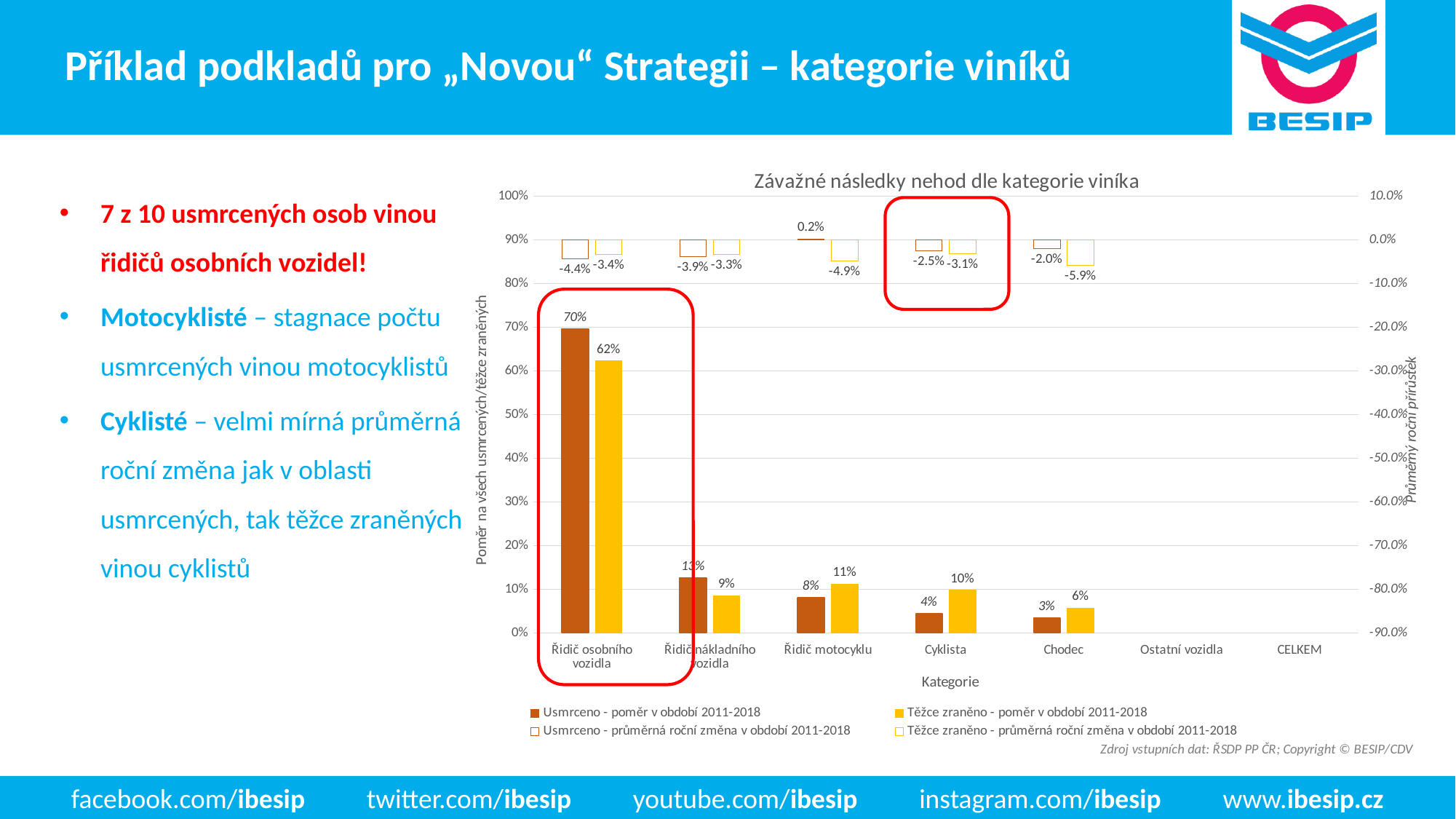
Which category has the lowest value for 'Těžce zraněno - poměr v období 2011-2018' among those with bars? Chodec Which category has the highest value for 'Usmrceno - poměr v období 2011-2018'? Řidič osobního vozidla What is the value of 'Těžce zraněno - průměrná roční změna v období 2011-2018' for Chodec? -5.9% For Řidič motocyklu, which is larger: 'Usmrceno - poměr v období 2011-2018' or 'Těžce zraněno - poměr v období 2011-2018'? Těžce zraněno - poměr v období 2011-2018 Is the value of 'Těžce zraněno - poměr v období 2011-2018' for Řidič osobního vozidla greater or less than 50%? greater What is the value of 'Usmrceno - průměrná roční změna v období 2011-2018' for Řidič motocyklu? 0.2% What is the value of 'Usmrceno - poměr v období 2011-2018' for Řidič osobního vozidla? 70% What type of chart is shown on the slide? bar chart What is the value of 'Těžce zraněno - poměr v období 2011-2018' for Cyklista? 10% How many series does the chart legend list? 4 What is the difference between the 'Usmrceno - poměr v období 2011-2018' values for Řidič osobního vozidla and Řidič nákladního vozidla? 57% What is the title of the chart? Závažné následky nehod dle kategorie viníka